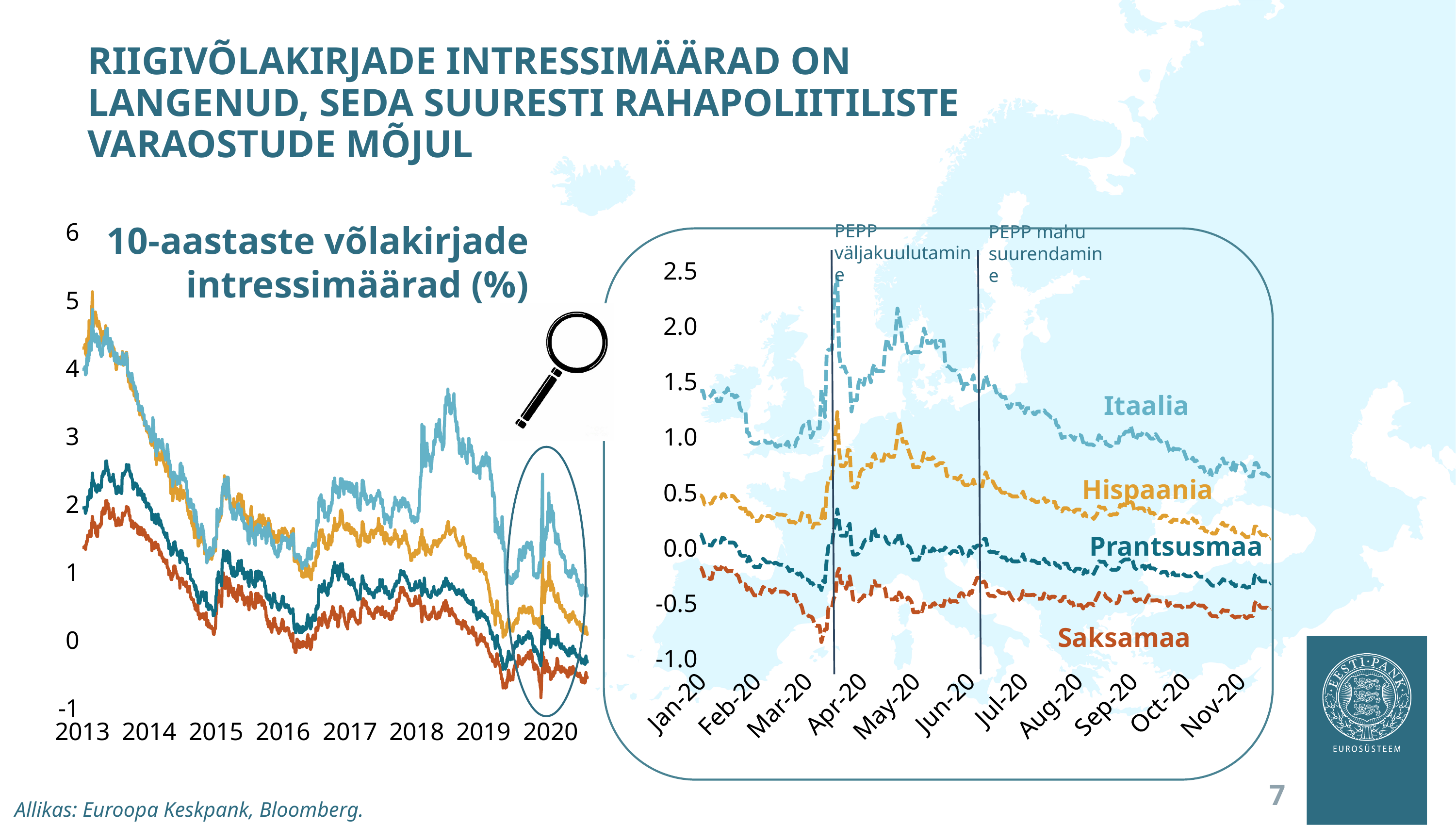
What are the two events marked by vertical lines on the right chart? PEPP väljakuulutamine and PEPP mahu suurendamine On the right chart, is the value for Itaalia in Nov-20 greater or less than 0.5? greater On the right chart, which is larger in Nov-20: the value for Itaalia or the value for Saksamaa? Itaalia On the right chart, which country's line is the lowest throughout the period? Saksamaa On the right chart, does the Itaalia line rise or fall from Apr-20 to Nov-20? fall On the right chart, is the peak value for Itaalia in Mar-20 greater or less than 2.0? greater What kind of chart is the left chart titled "10-aastaste võlakirjade intressimäärad (%)"? line chart How many lines (series) are plotted on the right chart covering Jan-20 to Nov-20? 4 On the left chart, do the interest rates overall rise or fall from 2013 to 2020? fall On the right chart, which country's line is the highest throughout the period? Itaalia How many month labels are shown on the x axis of the right chart? 11 On the right chart, is the value for Saksamaa in Nov-20 greater or less than 0.0? less